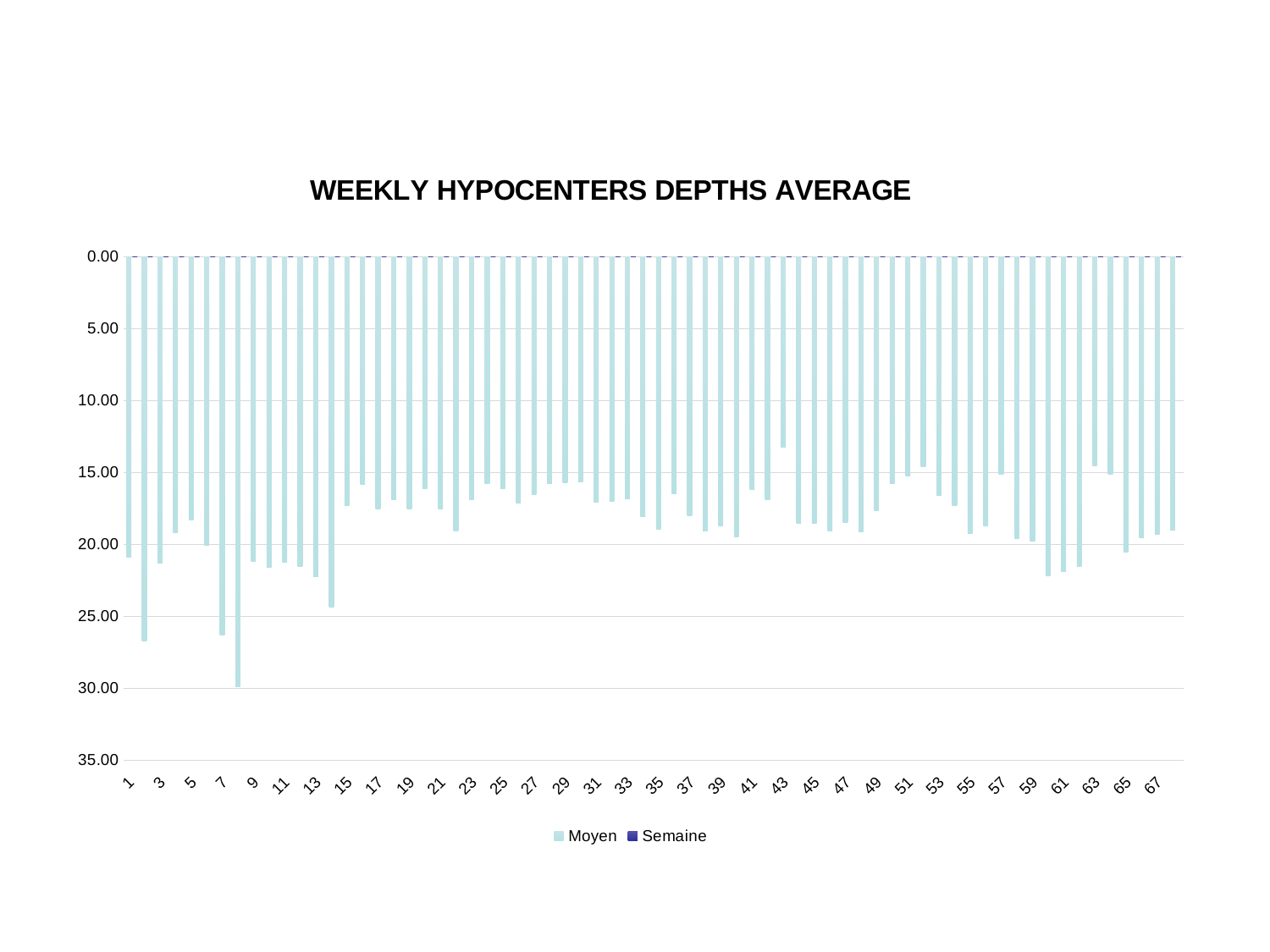
Is the value for week 15 greater or less than 20.00? less Is the value for week 8 greater or less than 25.00? greater What are the two series names shown in the legend? Moyen and Semaine Which bar is longer, week 43 or week 8? Week 8 Is the value for week 43 greater or less than 15.00? less Which bar is longer, week 8 or week 2? Week 8 Which week has the longest bar (the greatest depth) on the chart? 8 What is the title of the chart? WEEKLY HYPOCENTERS DEPTHS AVERAGE What kind of chart is shown on the slide? Bar chart How many series does the legend list? 2